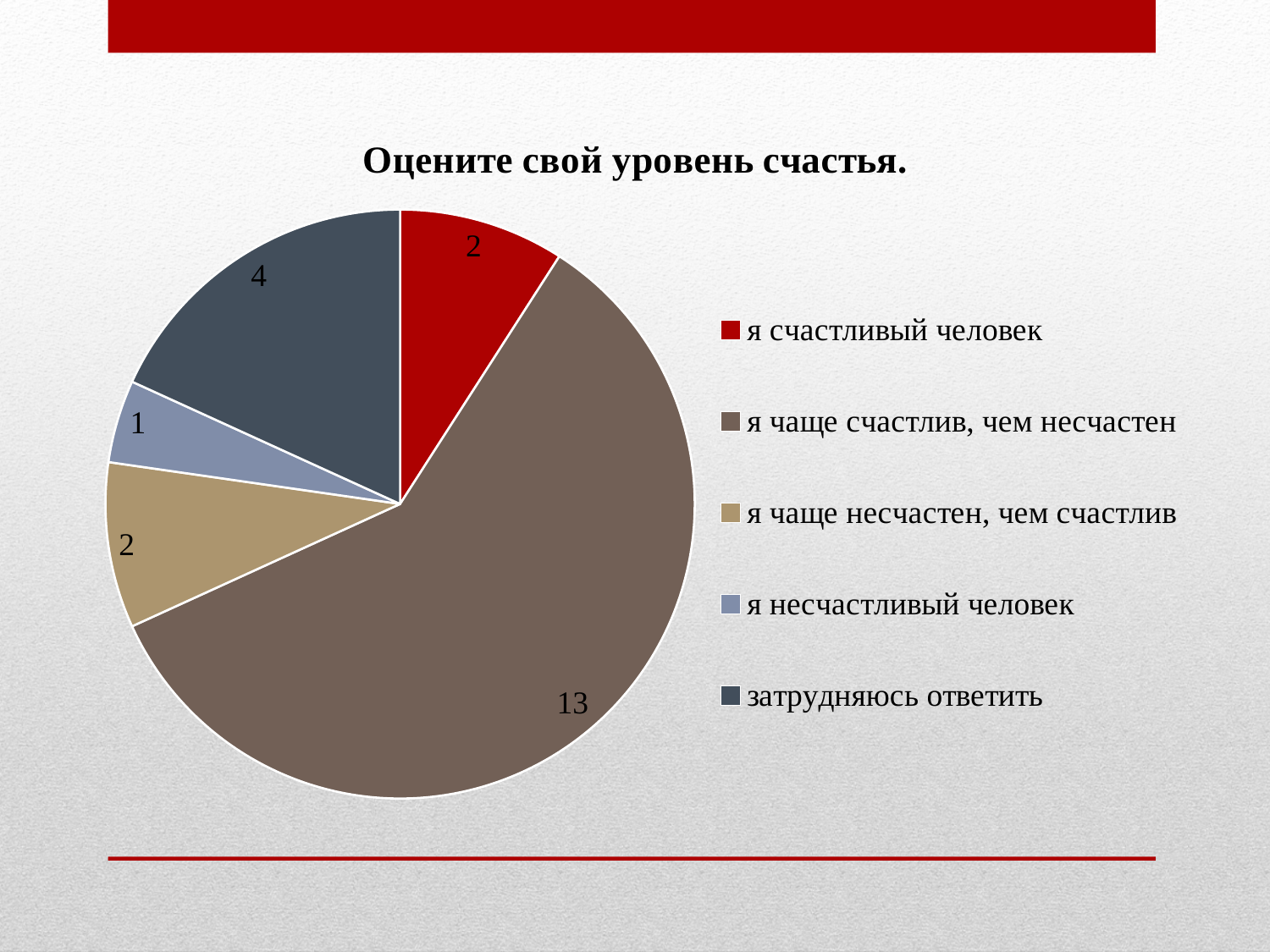
How many entries does the legend list? 5 Which category has the largest slice? я чаще счастлив, чем несчастен What is the value for "затрудняюсь ответить"? 4 What kind of chart is shown on the slide? pie chart What is the value for "я несчастливый человек"? 1 What is the value for "я счастливый человек"? 2 What is the title of the chart? Оцените свой уровень счастья. Which is larger: the value for "затрудняюсь ответить" or the value for "я чаще несчастен, чем счастлив"? затрудняюсь ответить How many slices does the pie chart have? 5 What is the value for "я чаще счастлив, чем несчастен"? 13 Which category has the smallest slice? я несчастливый человек What is the difference between the values for "я чаще счастлив, чем несчастен" and "затрудняюсь ответить"? 9